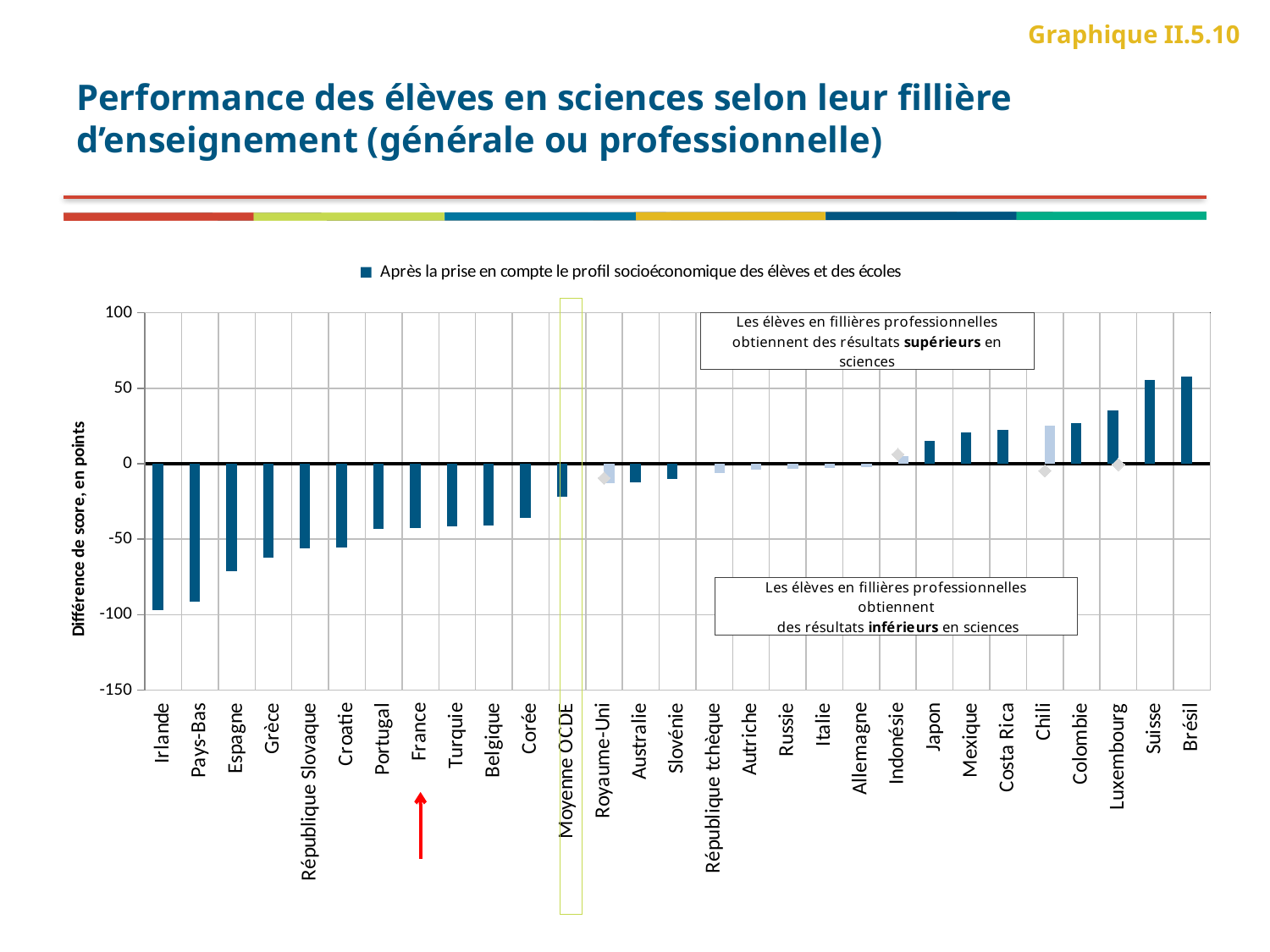
Is the value for Suisse greater or less than 50? greater How many categories are shown on the x axis of the chart? 29 Is the value for Portugal greater or less than -50? greater What kind of chart is shown on the slide? bar chart Is the value for Irlande greater or less than -50? less Which has the larger value, Brésil or Colombie? Brésil How many series does the legend list? 1 Do the values generally rise or fall moving from left to right along the x axis? rise Which has the larger value, Pays-Bas or Irlande? Pays-Bas What is the label of the y axis? Différence de score, en points Which category has the lowest value in the chart? Irlande